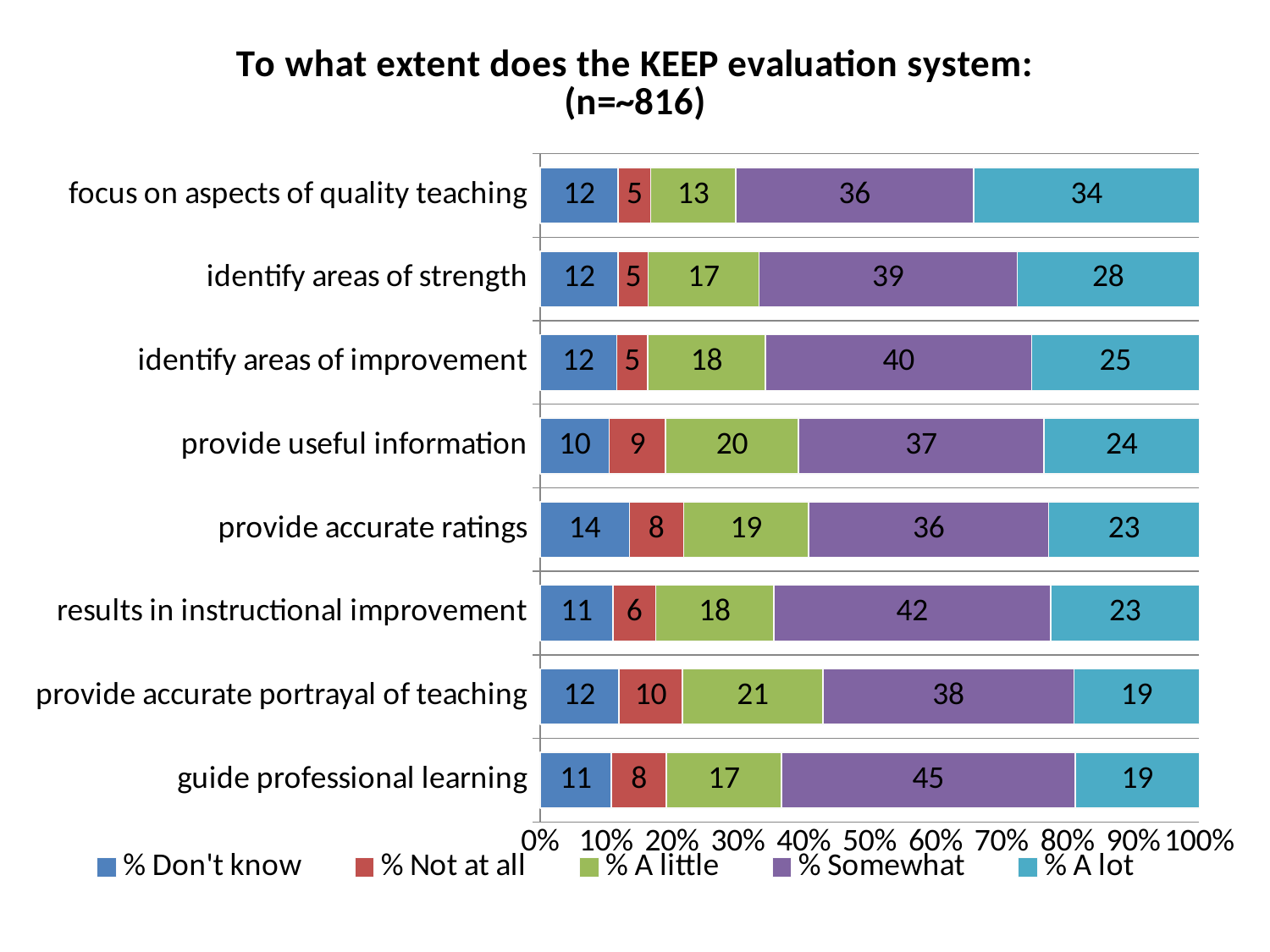
What is the "% Somewhat" value for "guide professional learning"? 45 What kind of chart is shown on the slide? stacked bar chart What is the total of the stacked bar for "provide accurate ratings"? 100 What is the "% A lot" value for "focus on aspects of quality teaching"? 34 What is the difference between the "% A lot" values for "identify areas of strength" and "guide professional learning"? 9 Which category has the highest "% A lot" value? focus on aspects of quality teaching Which legend entry is shown in green? % A little How many categories are shown on the chart? 8 Which is larger: the "% A little" value for "provide useful information" or for "provide accurate ratings"? provide useful information What is the "% Not at all" value for "provide accurate portrayal of teaching"? 10 How many series does the legend list? 5